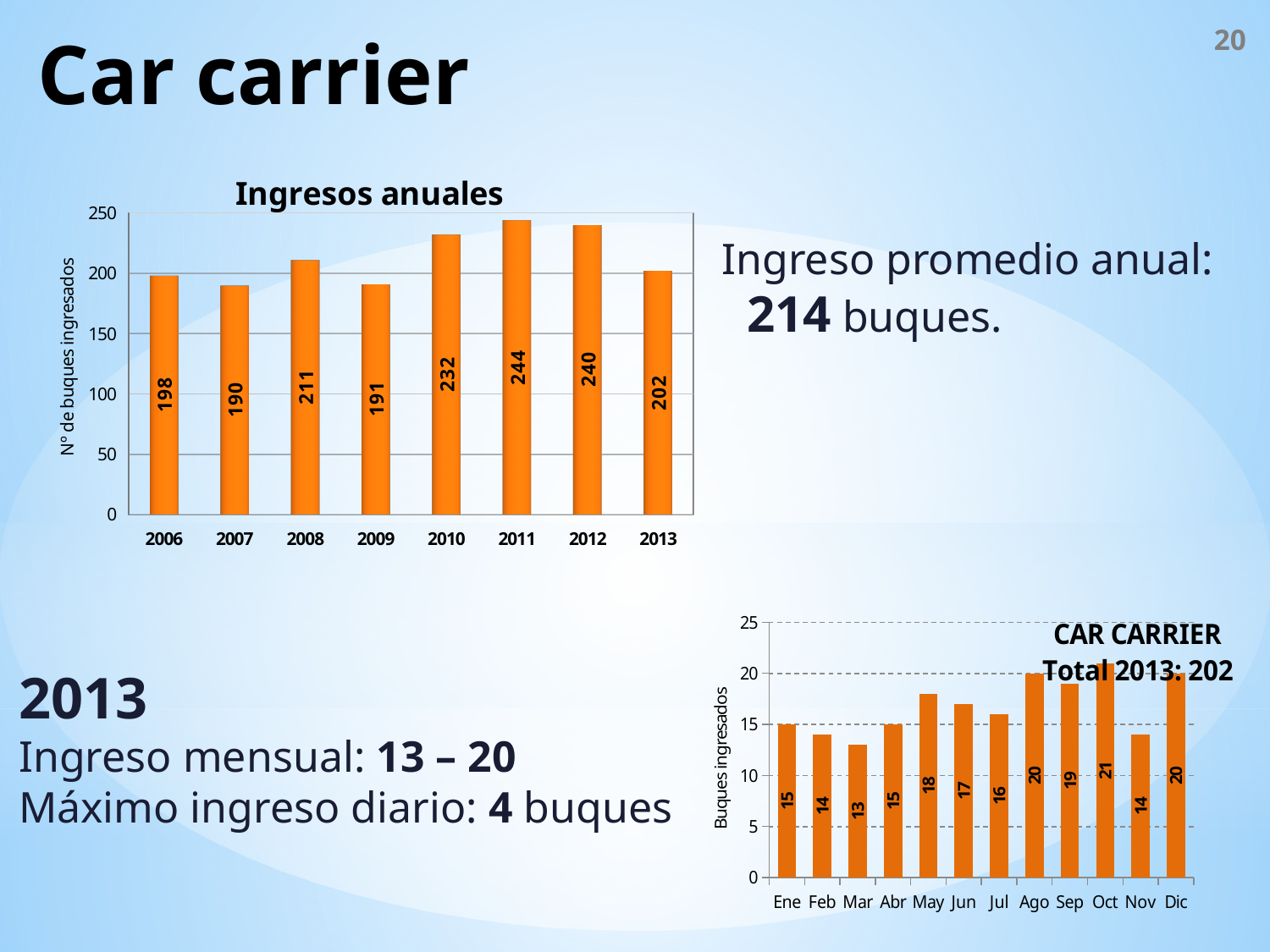
In the 'CAR CARRIER Total 2013: 202' chart, what is the value for Oct? 21 In the 'Ingresos anuales' chart, what is the value for 2010? 232 In the 'Ingresos anuales' chart, which year has the highest value? 2011 In the 'Ingresos anuales' chart, which is larger, the value for 2008 or the value for 2009? 2008 What is the y-axis label of the 'Ingresos anuales' chart? Nº de buques ingresados In the 'Ingresos anuales' chart, what is the difference between the values for 2011 and 2013? 42 In the 'Ingresos anuales' chart, which year has the lowest value? 2007 In the 'CAR CARRIER Total 2013: 202' chart, what is the difference between the values for Ago and Feb? 6 What type of chart is the 'Ingresos anuales' chart? Bar chart How many years are shown in the 'Ingresos anuales' chart? 8 How many months are shown in the 'CAR CARRIER Total 2013: 202' chart? 12 In the 'CAR CARRIER Total 2013: 202' chart, which month has the lowest value? Mar